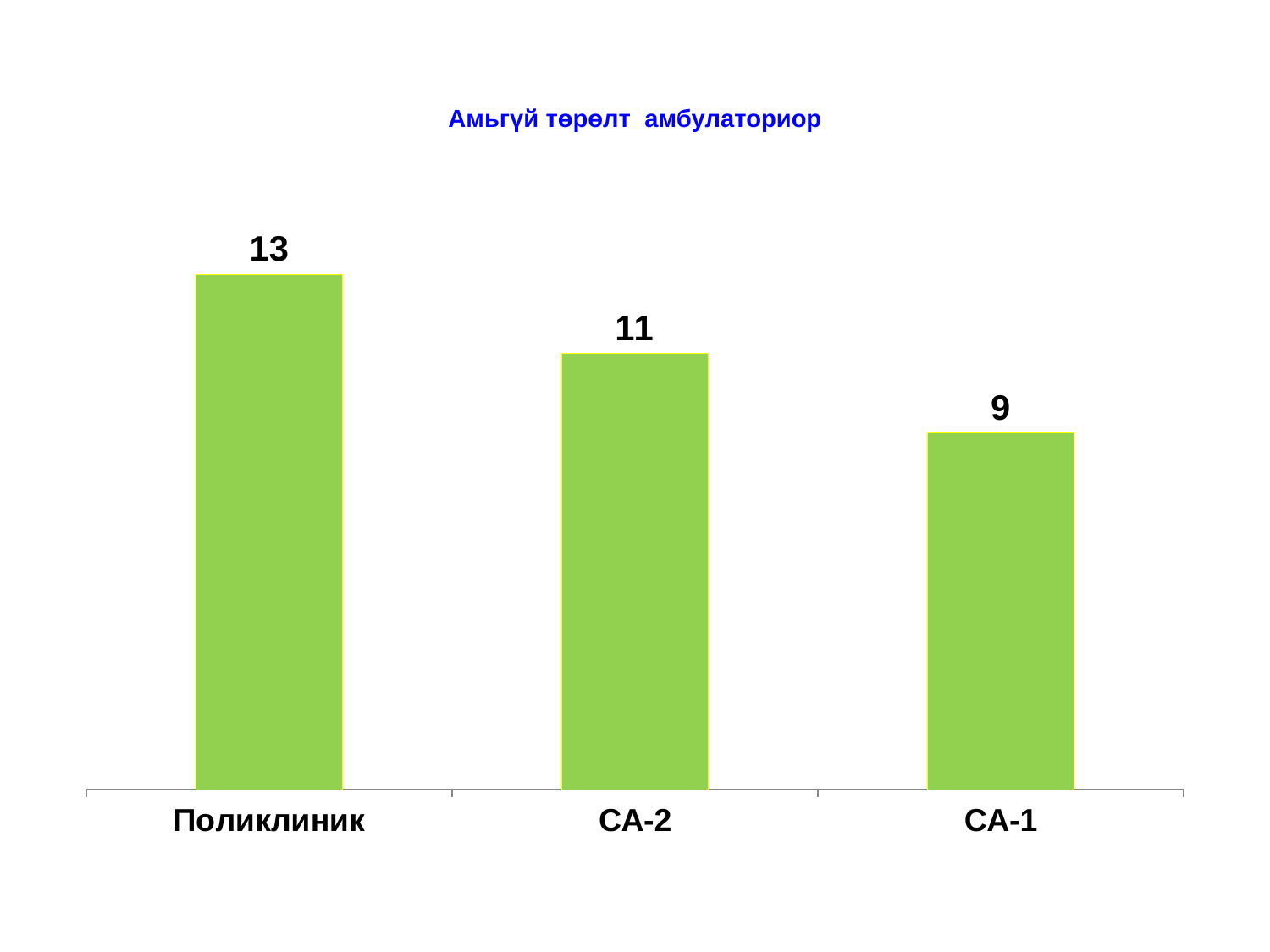
What kind of chart is shown on the slide? bar chart Which category has the lowest value? СА-1 What is the value for Поликлиник? 13 How many categories are shown in the chart? 3 What is the title of the chart? Амьгүй төрөлт амбулаториор What is the difference between the values for Поликлиник and СА-1? 4 Which category has the highest value? Поликлиник Which is larger, the value for СА-2 or the value for СА-1? СА-2 What is the value for СА-2? 11 What is the difference between the values for СА-2 and СА-1? 2 What is the value for СА-1? 9 Do the values rise or fall from left to right across the categories? fall